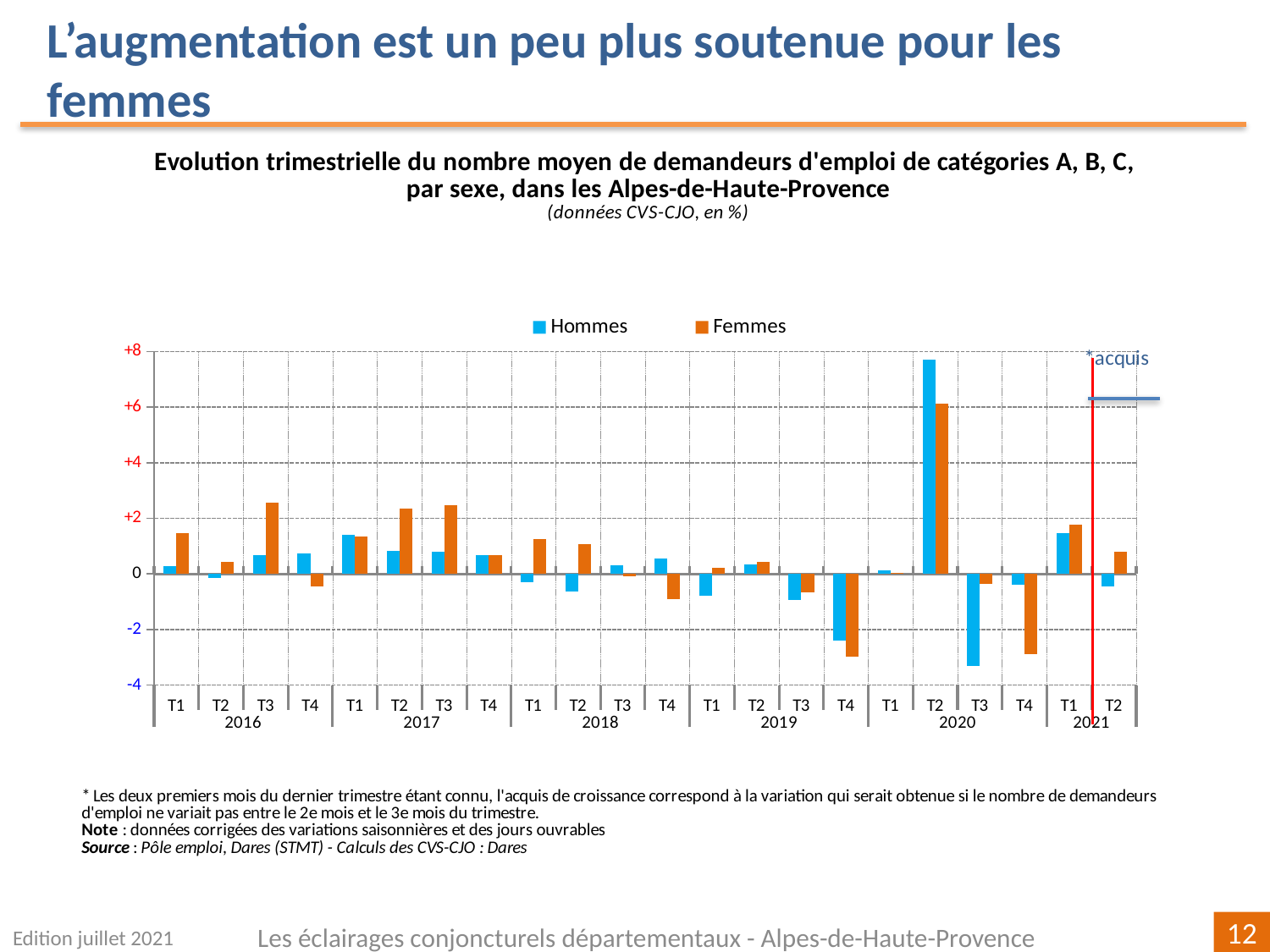
How many quarters (bar groups) are plotted along the x axis? 22 In which quarter is the value for Hommes the lowest? T3 2020 Which two series are listed in the legend? Hommes and Femmes What kind of chart is shown on the slide? Bar chart In which quarter is the value for Femmes the highest? T2 2020 Is the value for Femmes in T2 2020 greater or less than +4? greater How many series does the legend list? 2 In T3 2016, which series has the larger value, Hommes or Femmes? Femmes Is the value for Hommes in T3 2020 greater or less than -2? less In which quarter is the value for Hommes the highest? T2 2020 Is the value for Hommes in T2 2020 greater or less than +6? greater In T2 2020, which series has the larger value, Hommes or Femmes? Hommes